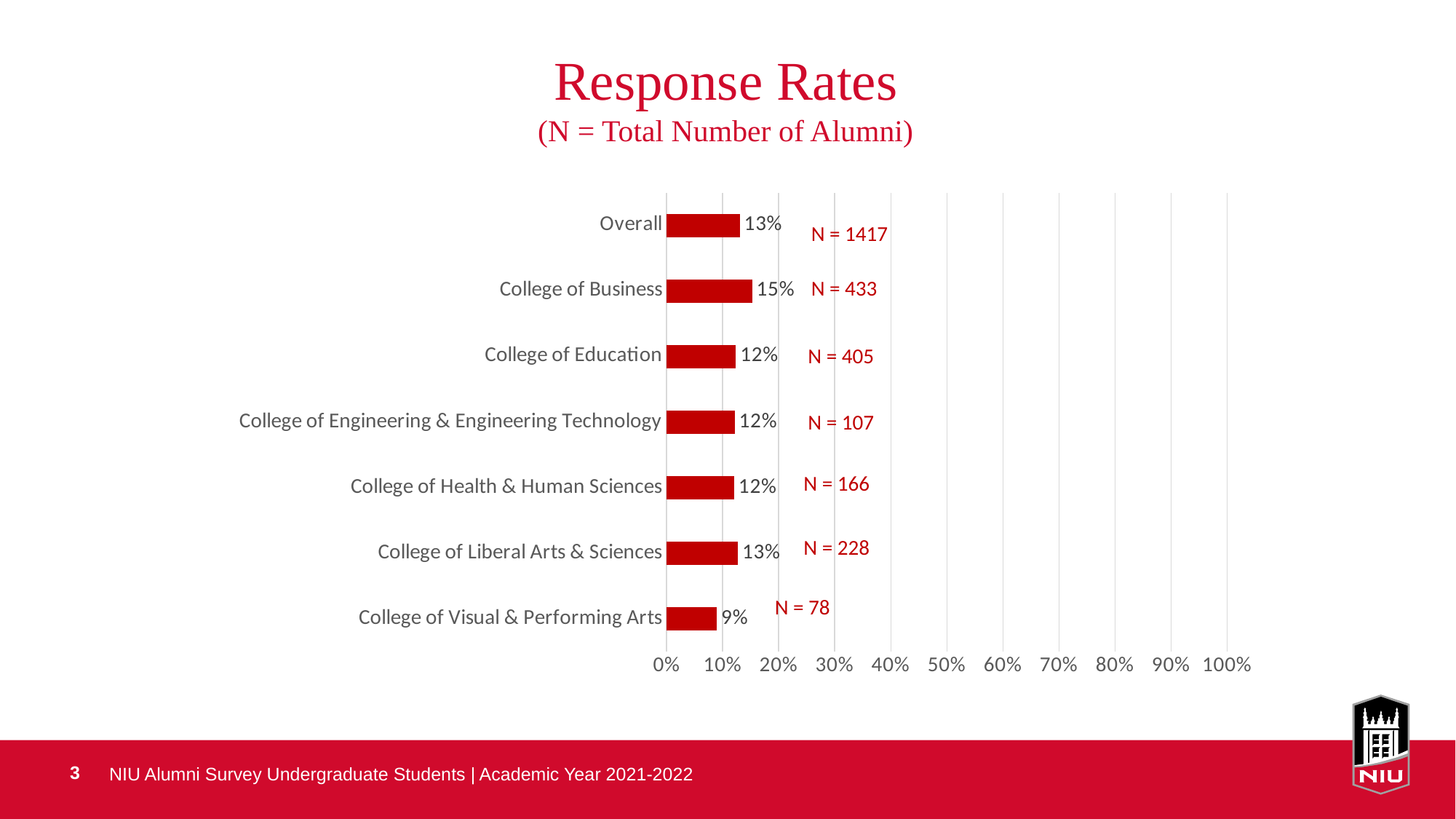
Is the response rate for the College of Visual & Performing Arts greater or less than 10%? less Which category has the lowest response rate? College of Visual & Performing Arts What is the Overall response rate? 13% Which has a higher response rate, the College of Business or the College of Liberal Arts & Sciences? College of Business What kind of chart is shown on the slide? bar chart Which category has the highest response rate? College of Business What is the total number of alumni (N) for the Overall category? 1417 What is the response rate for the College of Business? 15% What is the difference between the response rates of the College of Business and the College of Visual & Performing Arts? 6% What is the response rate for the College of Visual & Performing Arts? 9% How many categories are shown in the chart? 7 What is the response rate for the College of Education? 12%